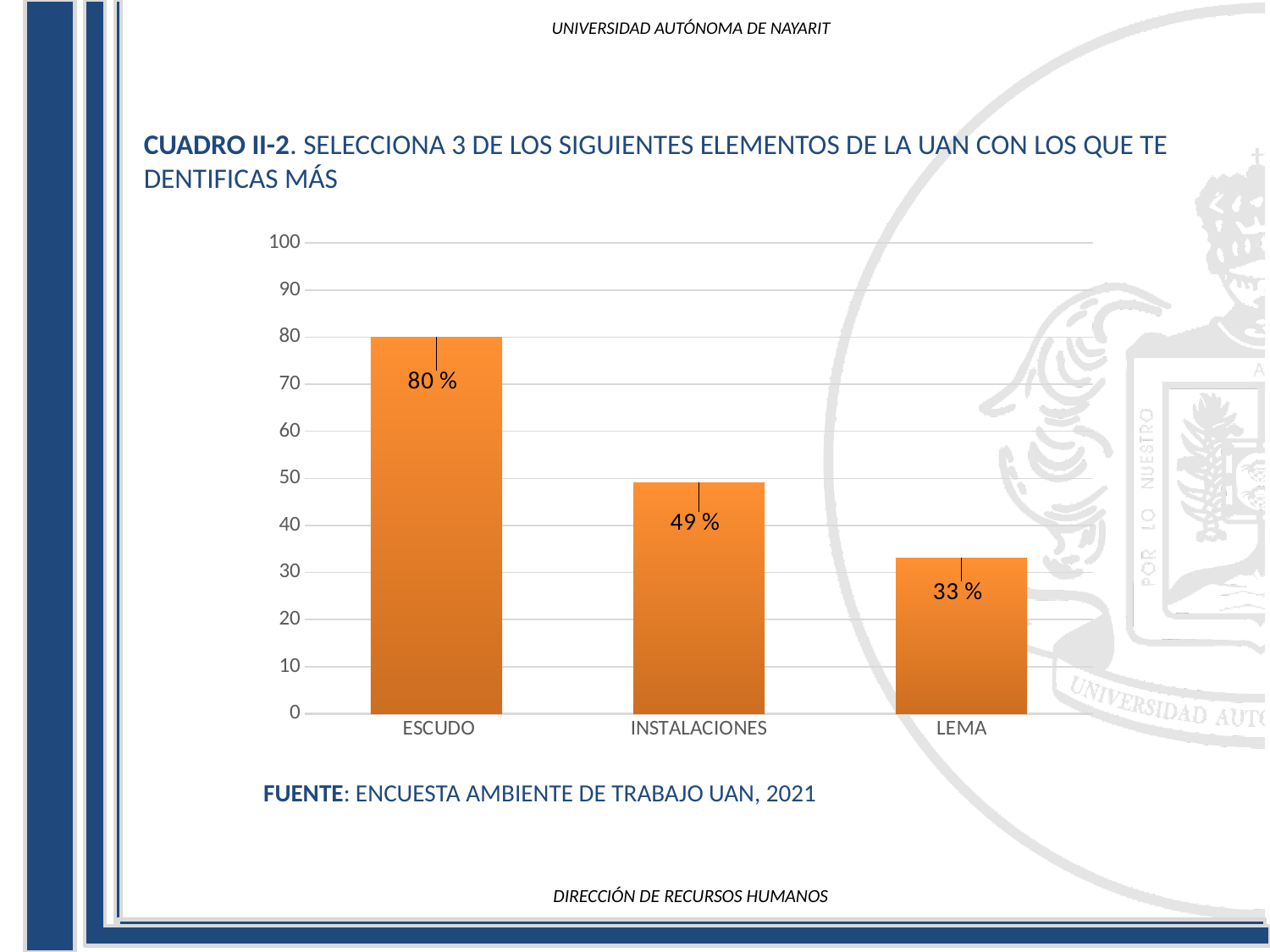
How many categories are shown on the x axis? 3 Do the values rise or fall from left to right along the x axis? fall What is the difference between the values for ESCUDO and INSTALACIONES? 31 % What kind of chart is shown on the slide? bar chart Which category has the highest value? ESCUDO What is the difference between the values for INSTALACIONES and LEMA? 16 % What is the value for LEMA? 33 % What is the value for ESCUDO? 80 % Is the value for LEMA greater or less than 40? less Which is larger, the value for INSTALACIONES or the value for LEMA? INSTALACIONES What is the value for INSTALACIONES? 49 % Which category has the lowest value? LEMA